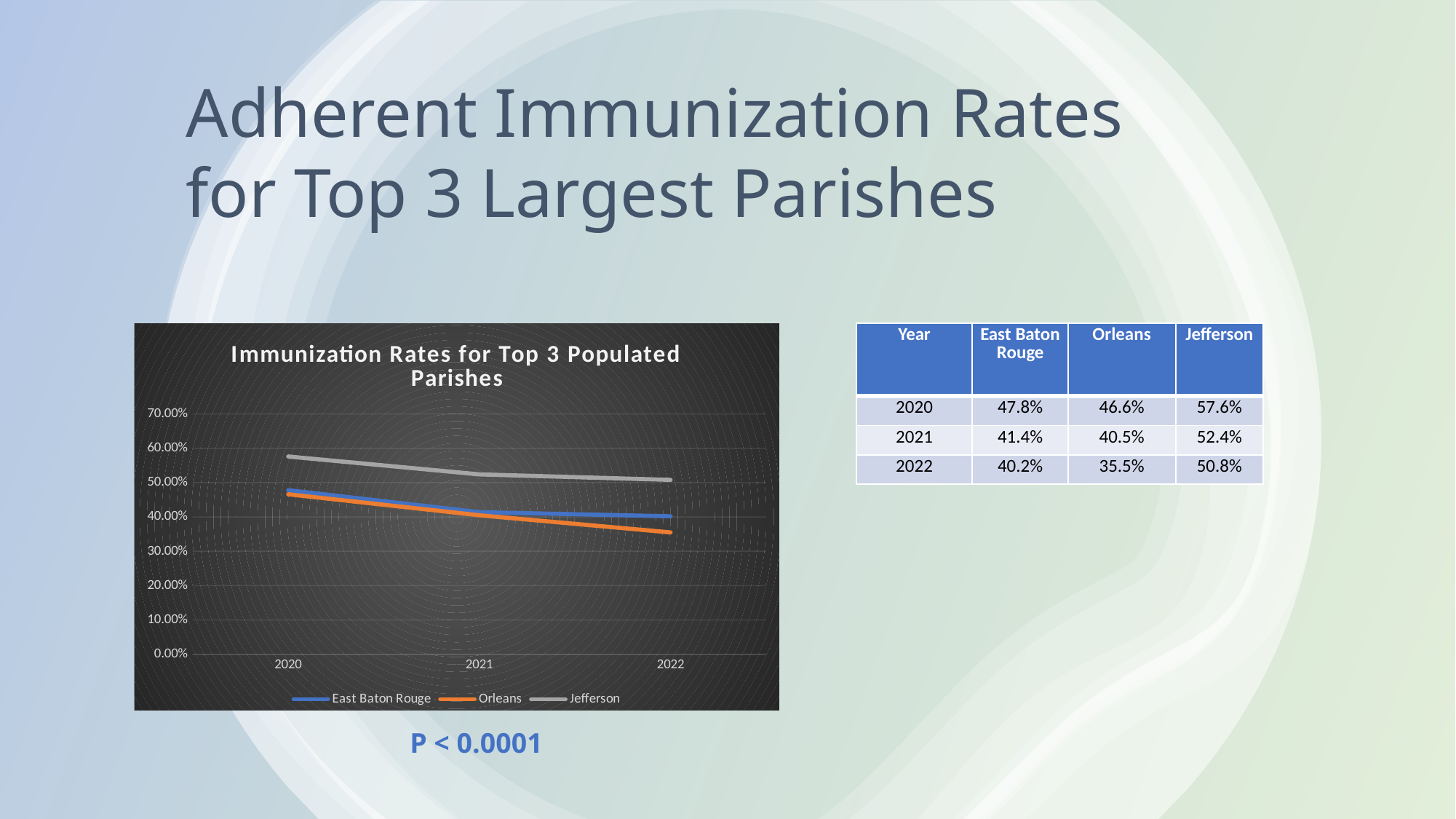
Is the value for Jefferson in 2022 greater or less than 40.00%? greater What is the immunization rate for Jefferson in 2020? 57.6% How many series does the chart's legend list? 3 Does the immunization rate for Orleans rise or fall from 2020 to 2022? fall What is the difference between Jefferson's and Orleans' immunization rates in 2020? 11.0% What kind of chart is shown on the slide? line chart Which parish has the lowest immunization rate in 2022? Orleans What is the title of the chart? Immunization Rates for Top 3 Populated Parishes How many years are plotted along the x axis of the chart? 3 What is the immunization rate for East Baton Rouge in 2021? 41.4% What is the immunization rate for Orleans in 2022? 35.5% Which parish has the highest immunization rate in 2022? Jefferson